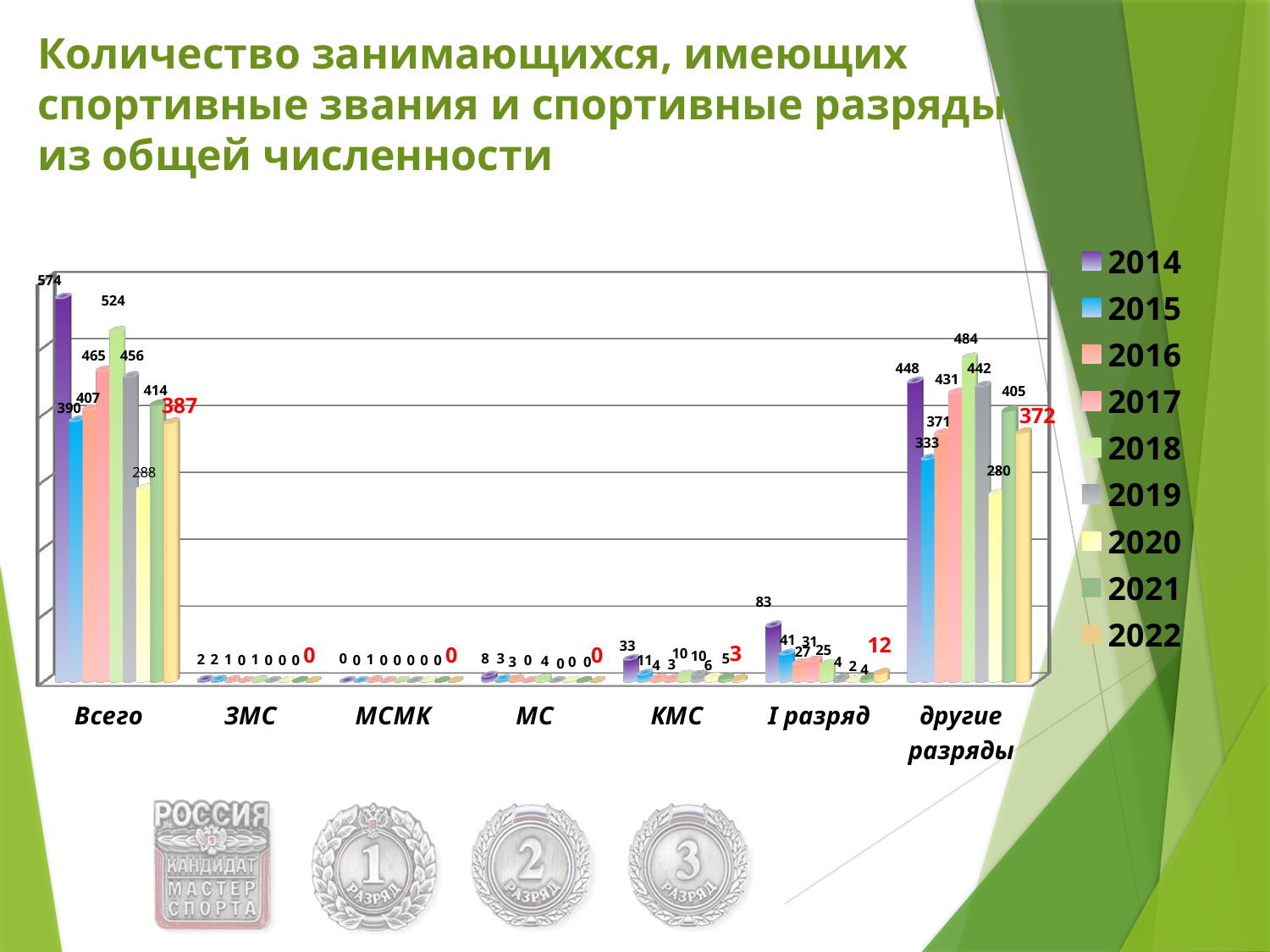
Which year has the highest value for другие разряды? 2018 How many series does the legend list? 9 What is the value for другие разряды in 2018? 484 Which year has the lowest value for Всего? 2020 For другие разряды, which is larger: the value for 2017 or for 2019? 2019 How many categories are shown on the x axis? 7 What is the value for КМС in 2014? 33 Which year has the highest value for Всего? 2014 What is the difference between the другие разряды values for 2018 and 2020? 204 What is the difference between the Всего values for 2014 and 2022? 187 What is the value for I разряд in 2022? 12 What is the value for Всего in 2014? 574